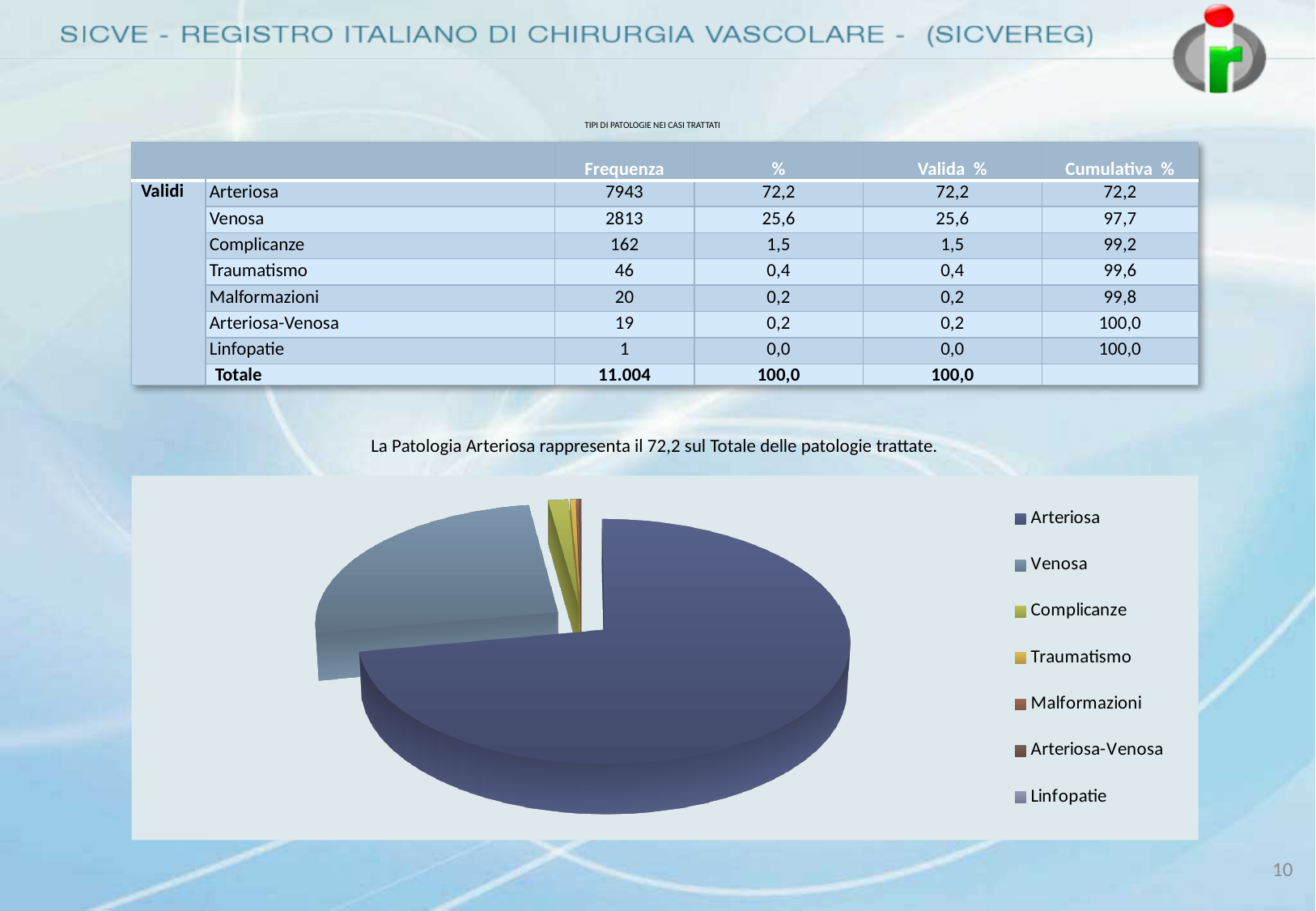
Which slice is larger in the pie chart, Arteriosa or Venosa? Arteriosa What percentage share of the total does the Arteriosa slice represent? 72,2 What percentage share of the total does the Venosa slice represent? 25,6 How many categories does the pie chart's legend list? 7 Which category has the largest slice in the pie chart? Arteriosa What kind of chart is shown on the slide? pie chart What frequency value does the Arteriosa slice of the pie chart represent? 7943 Which slice is larger in the pie chart, Venosa or Complicanze? Venosa What is the total frequency represented by all slices of the pie chart? 11.004 Which category has the second largest slice in the pie chart? Venosa What frequency value does the Venosa slice of the pie chart represent? 2813 What is the difference in frequency between the Arteriosa and Venosa slices? 5130